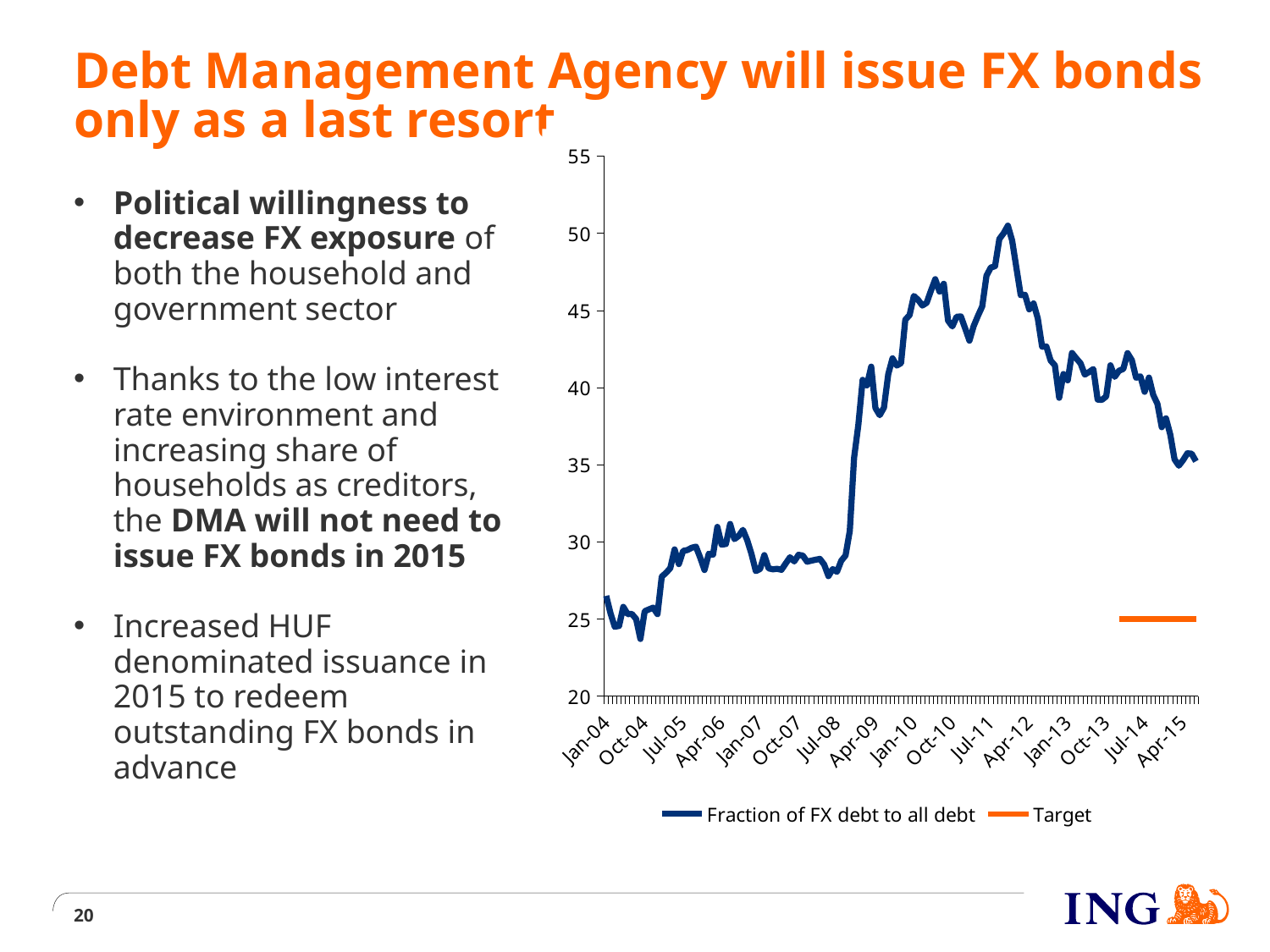
Is the value of the Fraction of FX debt to all debt line at Jan-04 greater or less than 30? less How many date labels are shown on the x axis? 16 What colour is the Target line in the chart? orange What kind of chart is shown on the slide? line chart What are the two series named in the chart legend? Fraction of FX debt to all debt; Target Is the highest value reached by the Fraction of FX debt to all debt line greater or less than 45? greater Does the Fraction of FX debt to all debt line rise or fall between Jul-11 and Apr-15? fall At what value on the y axis does the Target line sit? 25 Is the lowest value of the Fraction of FX debt to all debt line greater or less than 25? less How many series does the chart legend list? 2 Which is larger, the Fraction of FX debt to all debt at Jul-08 or at Apr-09? Apr-09